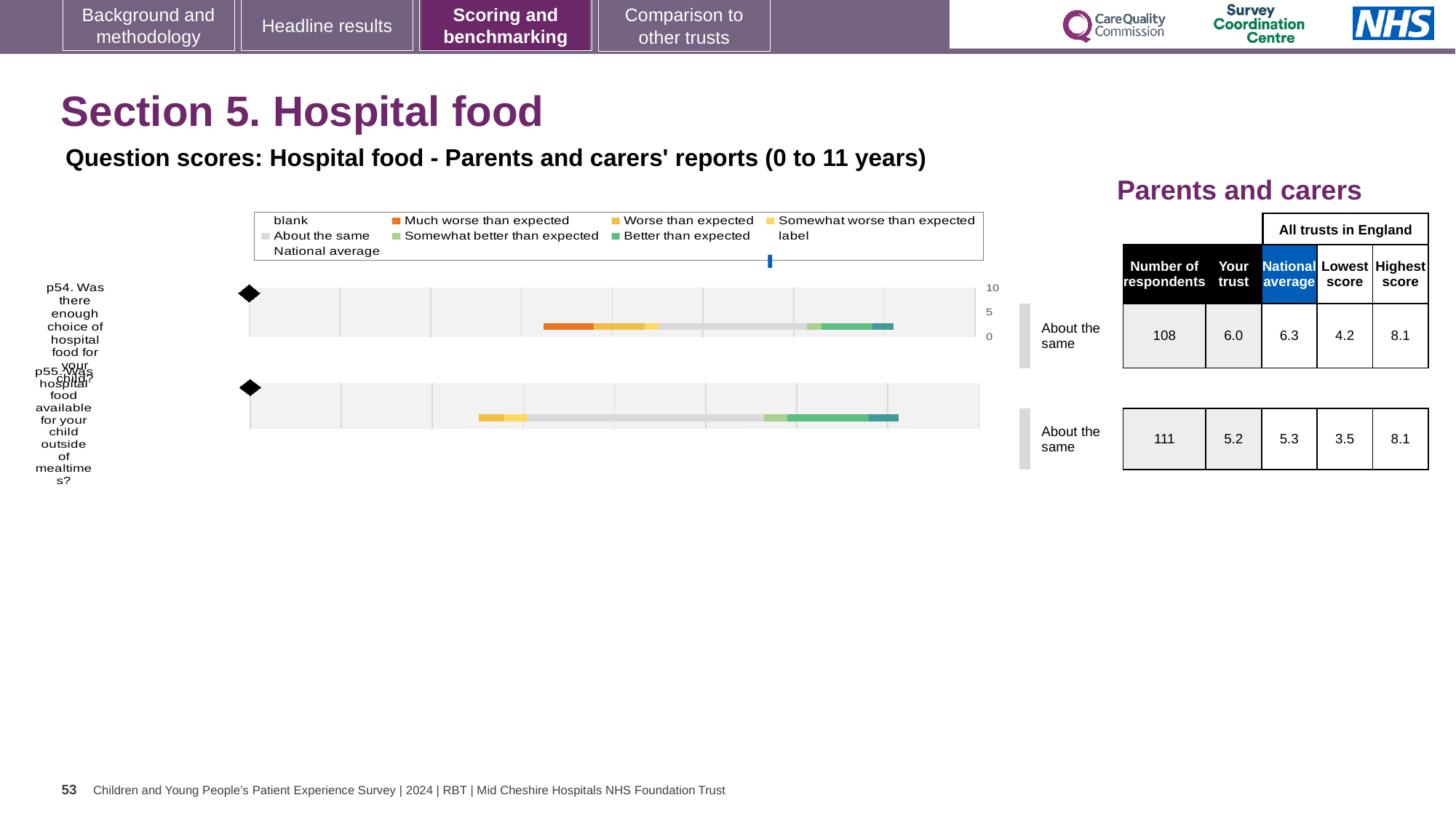
What is the difference between the national average and the 'Your trust' score for p54? 0.3 What is the highest value shown on the chart's numeric axis? 10 What is the lowest score across all trusts in England for p55? 3.5 In the table beside the chart, what is the national average for p55 (food available outside of mealtimes)? 5.3 In the table beside the chart, how many respondents answered p55? 111 What kind of chart is shown on the slide? bar chart How many questions (categories) are plotted in the chart? 2 What colour does the legend use for 'Much worse than expected'? orange Which question has the lower 'Your trust' score, p54 or p55? p55 For p54, which is larger: the 'Your trust' score or the national average? National average In the table beside the chart, what is the 'Your trust' score for p54 (enough choice of hospital food)? 6.0 How many entries does the chart legend list? 9